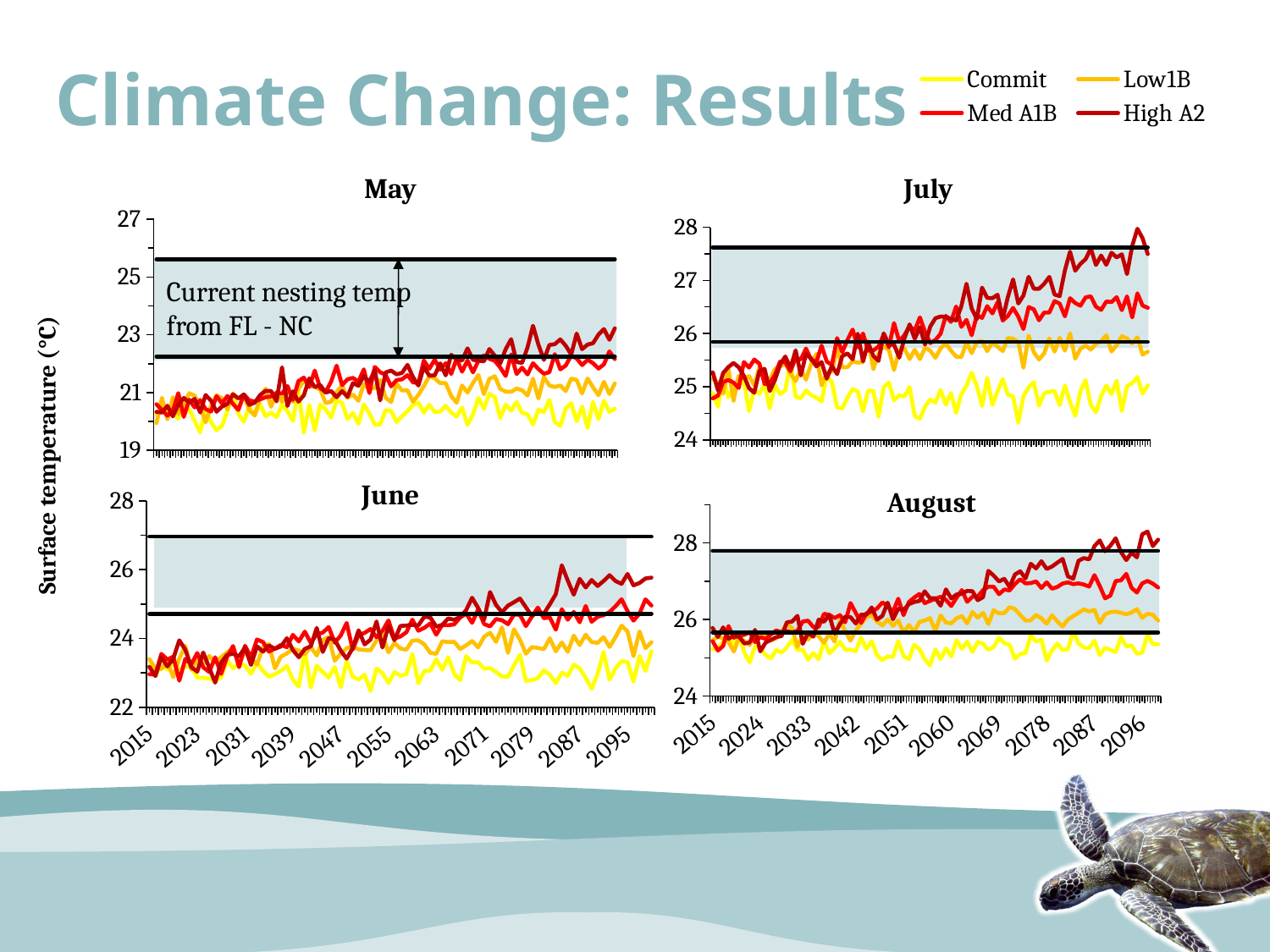
In the July chart, does the High A2 series rise or fall from 2015 to the end of the period? rise How many series does the legend list? 4 In the July chart, which series is higher at the end of the period, High A2 or Commit? High A2 In the July chart, is the value for High A2 at the end of the period greater or less than 27? greater What is the y-axis label shared by the charts? Surface temperature (°C) In the May chart, is the value for Commit at the end of the period greater or less than 21? less How many charts are shown on the slide? 4 In the August chart, is the value for Commit at the end of the period greater or less than 26? less What are the four series named in the legend? Commit, Low1B, Med A1B, High A2 In the August chart, which series is lowest at the end of the period? Commit What kind of chart is the May chart? line chart